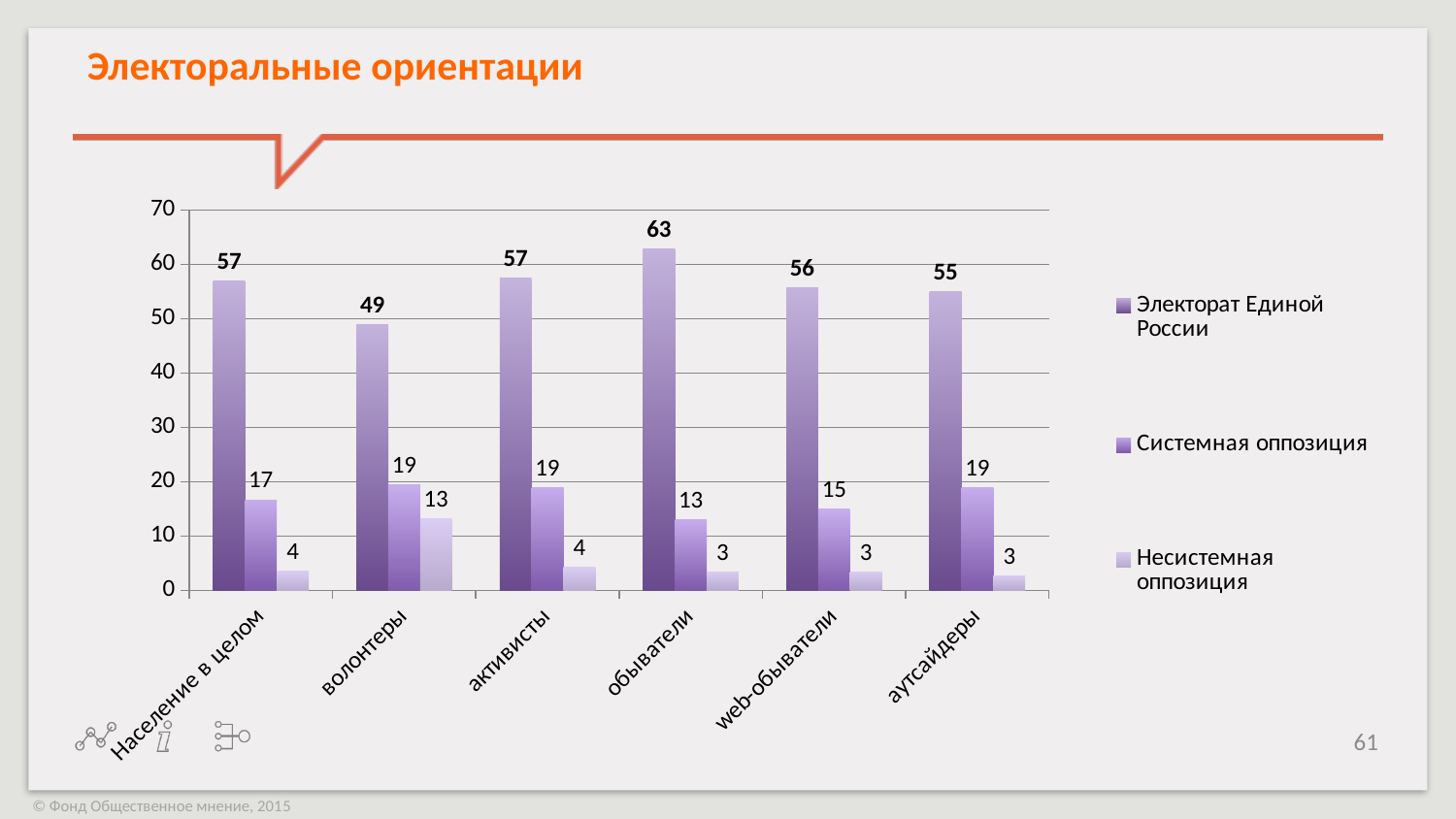
Which category has the highest value for "Электорат Единой России"? обыватели How many categories are shown on the x axis? 6 What kind of chart is shown on the slide? Bar chart What is the value for "Электорат Единой России" in the "обыватели" category? 63 What is the value for "Несистемная оппозиция" in the "волонтеры" category? 13 What is the value for "Системная оппозиция" in the "web-обыватели" category? 15 How many series does the legend list? 3 Which category has the lowest value for "Электорат Единой России"? волонтеры Which is larger: the "Системная оппозиция" value for "Население в целом" or for "обыватели"? Население в целом Which category has the highest value for "Несистемная оппозиция"? волонтеры What is the difference between the "Электорат Единой России" values for "обыватели" and "волонтеры"? 14 What is the title of the slide? Электоральные ориентации